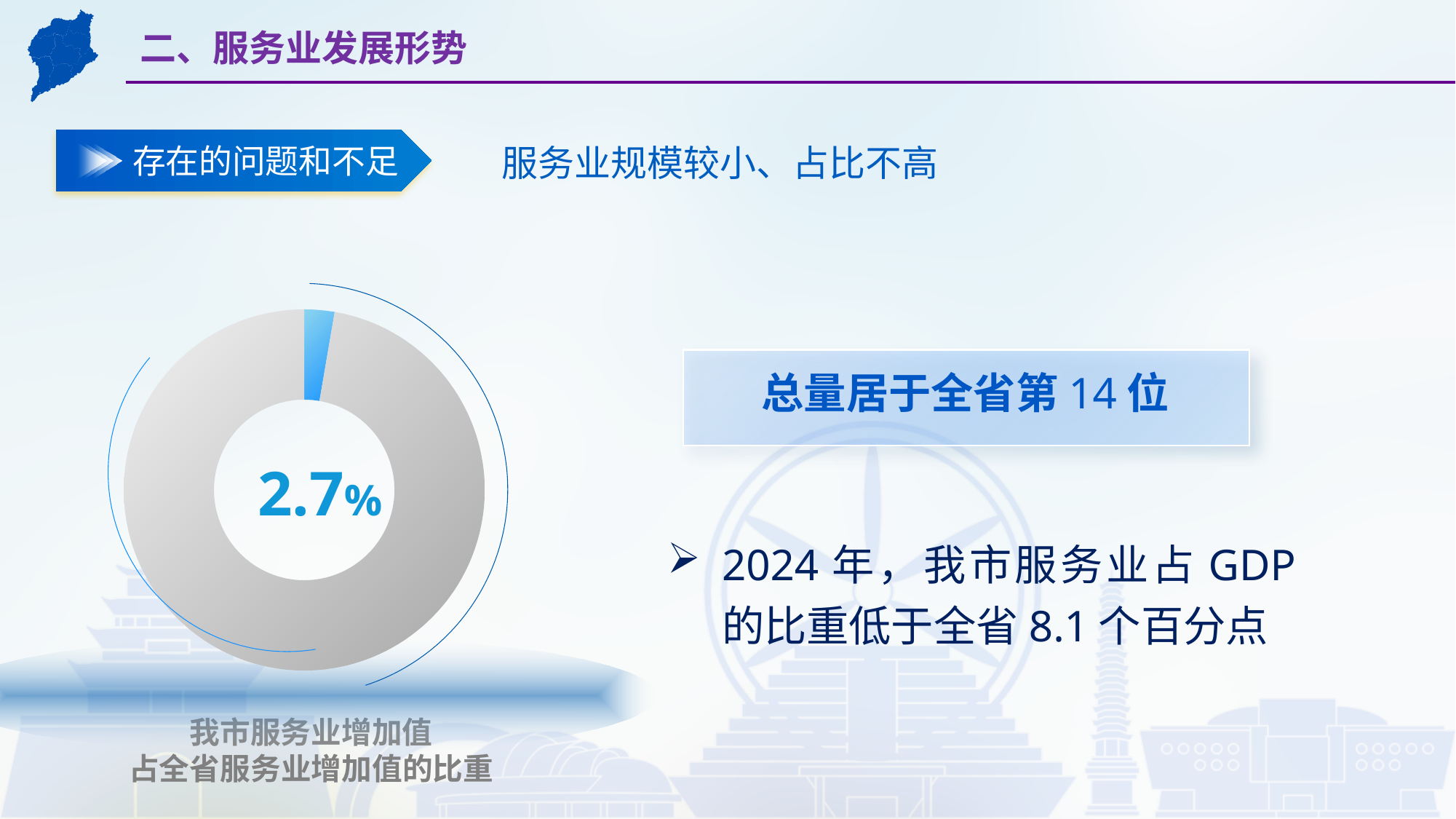
What kind of chart is shown on the left of the slide? Pie chart (donut) What value is printed in the centre of the donut chart? 2.7% What colour is the highlighted slice in the donut chart? Blue Which segment of the donut chart is larger, the blue slice or the grey remainder? The grey remainder What share of the donut chart does the blue slice represent? 2.7% What does the caption below the donut chart say the chart shows? 我市服务业增加值占全省服务业增加值的比重 How many segments does the donut chart have? 2